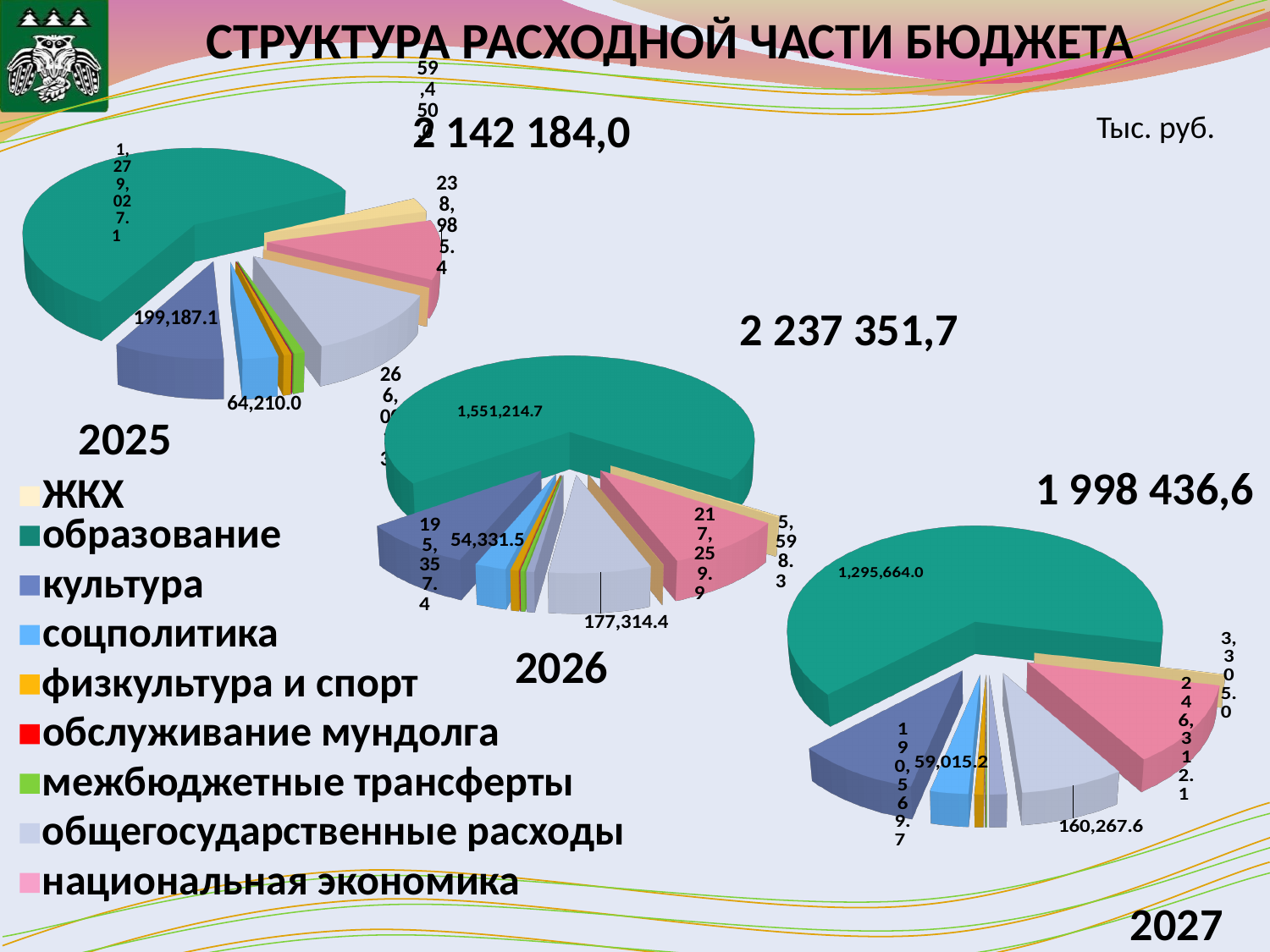
In the 2026 pie chart, what is the value for образование? 1,551,214.7 In the 2026 pie chart, what is the difference between культура (195,357.4) and соцполитика (54,331.5)? 141,025.9 How many pie charts are shown on the slide? 3 How many categories does the legend list? 9 In the 2026 pie chart, what is the value for общегосударственные расходы? 177,314.4 What kind of chart is used on this slide to show the budget expenditure structure? Pie chart In the 2026 pie chart, which is larger: культура or соцполитика? культура In the 2027 pie chart, what is the value for общегосударственные расходы? 160,267.6 In the 2027 pie chart, what is the value for образование? 1,295,664.0 In the 2026 pie chart, what is the value for соцполитика? 54,331.5 In the 2025 pie chart, what is the value for культура? 199,187.1 In the 2027 pie chart, which category has the largest slice? образование